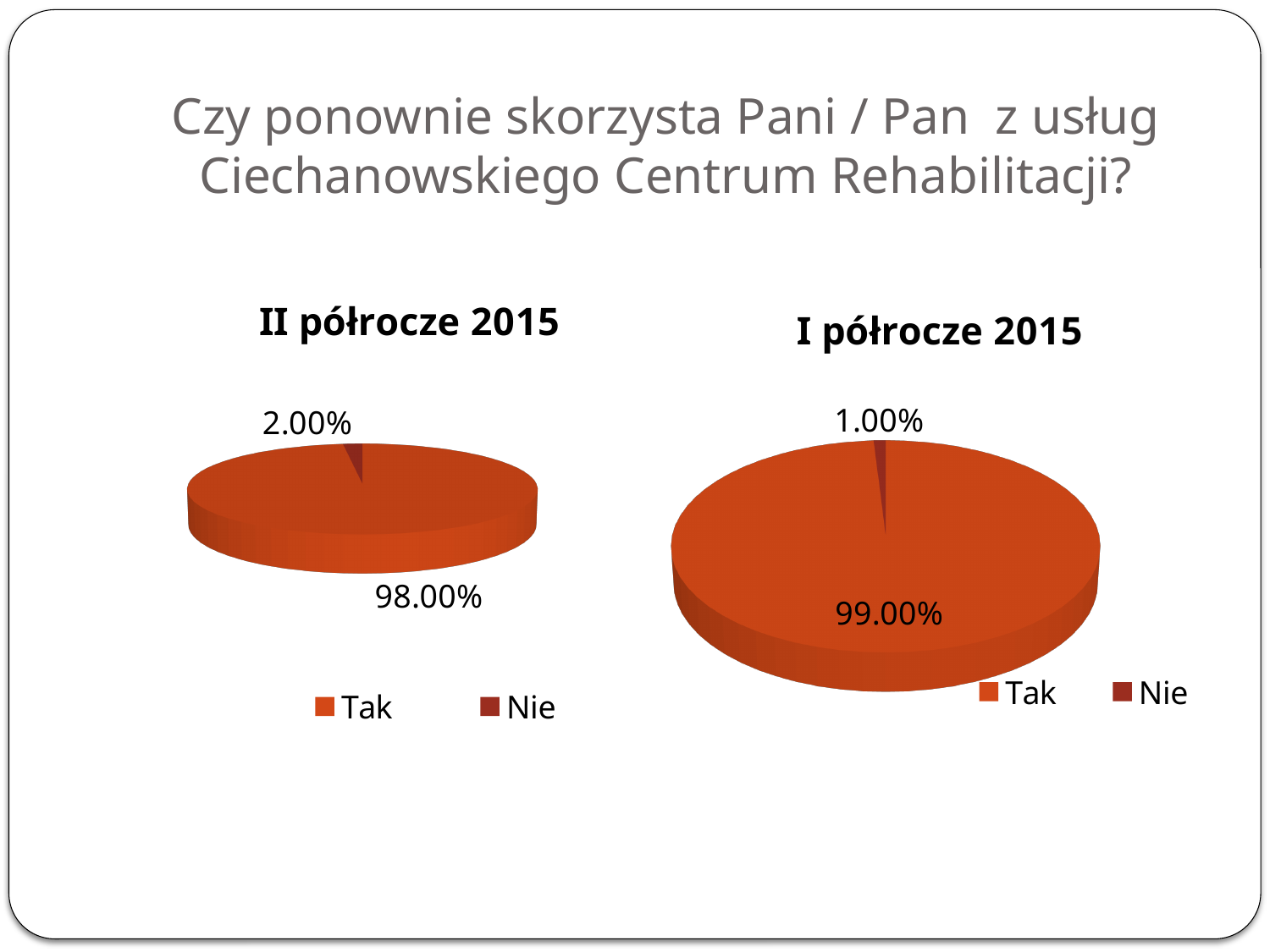
In the 'II półrocze 2015' chart, what is the value for Tak? 98.00% Which is larger: the Nie value in the 'II półrocze 2015' chart or the Nie value in the 'I półrocze 2015' chart? II półrocze 2015 In the 'I półrocze 2015' chart, which category has the largest slice? Tak In the 'I półrocze 2015' chart, what is the value for Nie? 1.00% How many slices does the 'II półrocze 2015' chart have? 2 What is the title of the chart on the left side of the slide? II półrocze 2015 In the 'II półrocze 2015' chart, what is the difference between the Tak and Nie values? 96.00% In the 'I półrocze 2015' chart, what is the value for Tak? 99.00% What kind of chart is the 'I półrocze 2015' chart? Pie chart How many entries does the legend of the 'I półrocze 2015' chart list? 2 In the 'II półrocze 2015' chart, what is the value for Nie? 2.00% In the 'II półrocze 2015' chart, which category has the smallest slice? Nie